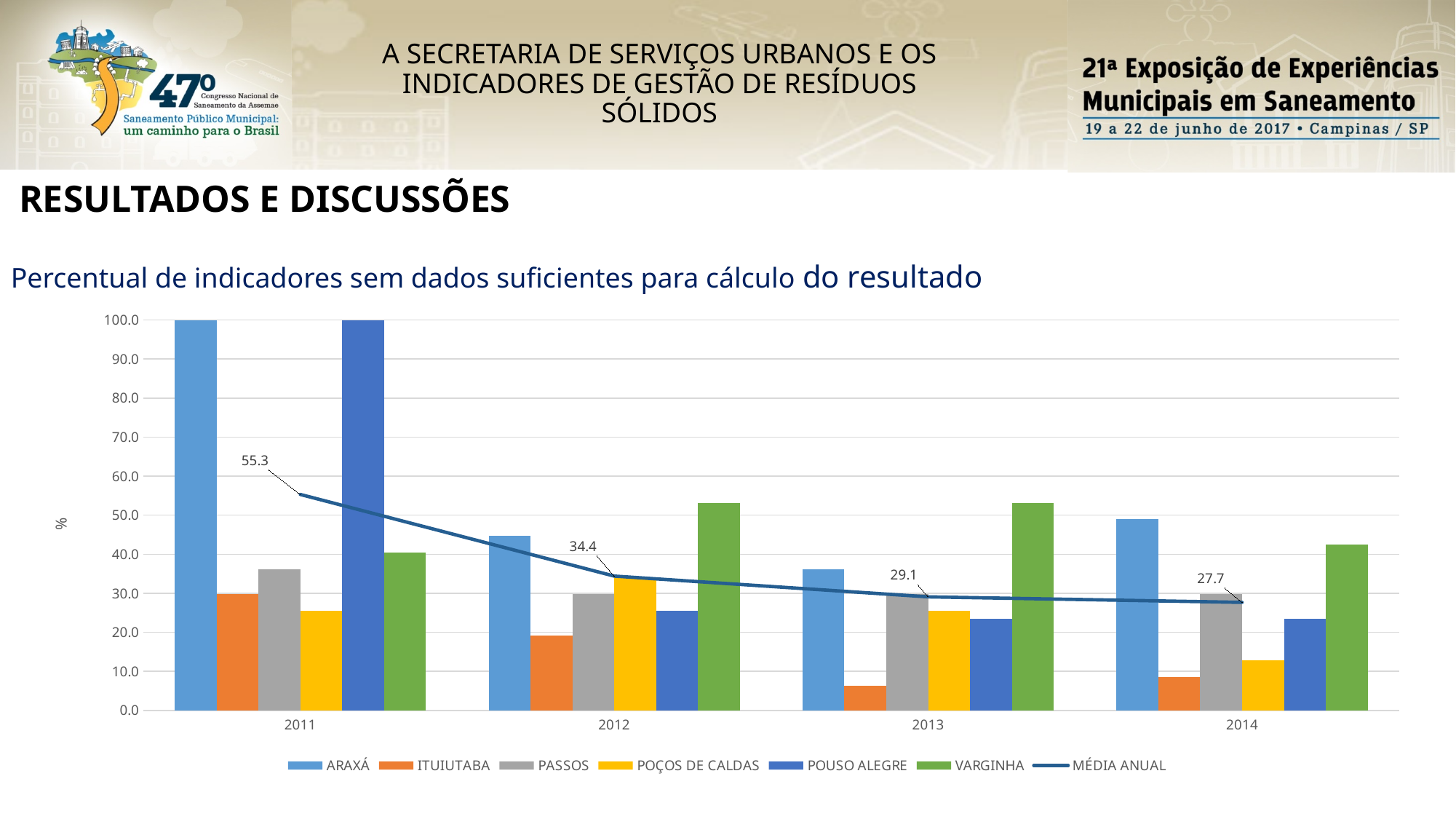
Is the value for ARAXÁ in 2014 greater or less than 40.0? greater Does the MÉDIA ANUAL line rise or fall from 2011 to 2014? It falls Which municipality has the highest bar in 2012? VARGINHA What is the MÉDIA ANUAL value for 2011? 55.3 What is the difference between the MÉDIA ANUAL values for 2012 and 2013? 5.3 What kind of chart is shown on the slide? A bar chart with a line series By how much did the MÉDIA ANUAL fall from 2011 to 2014? 27.6 Which municipality has the lowest bar in 2013? ITUIUTABA How many series does the legend list? 7 What is the value for ARAXÁ in 2011? 100.0 How many years are shown on the x axis? 4 What is the MÉDIA ANUAL value for 2014? 27.7